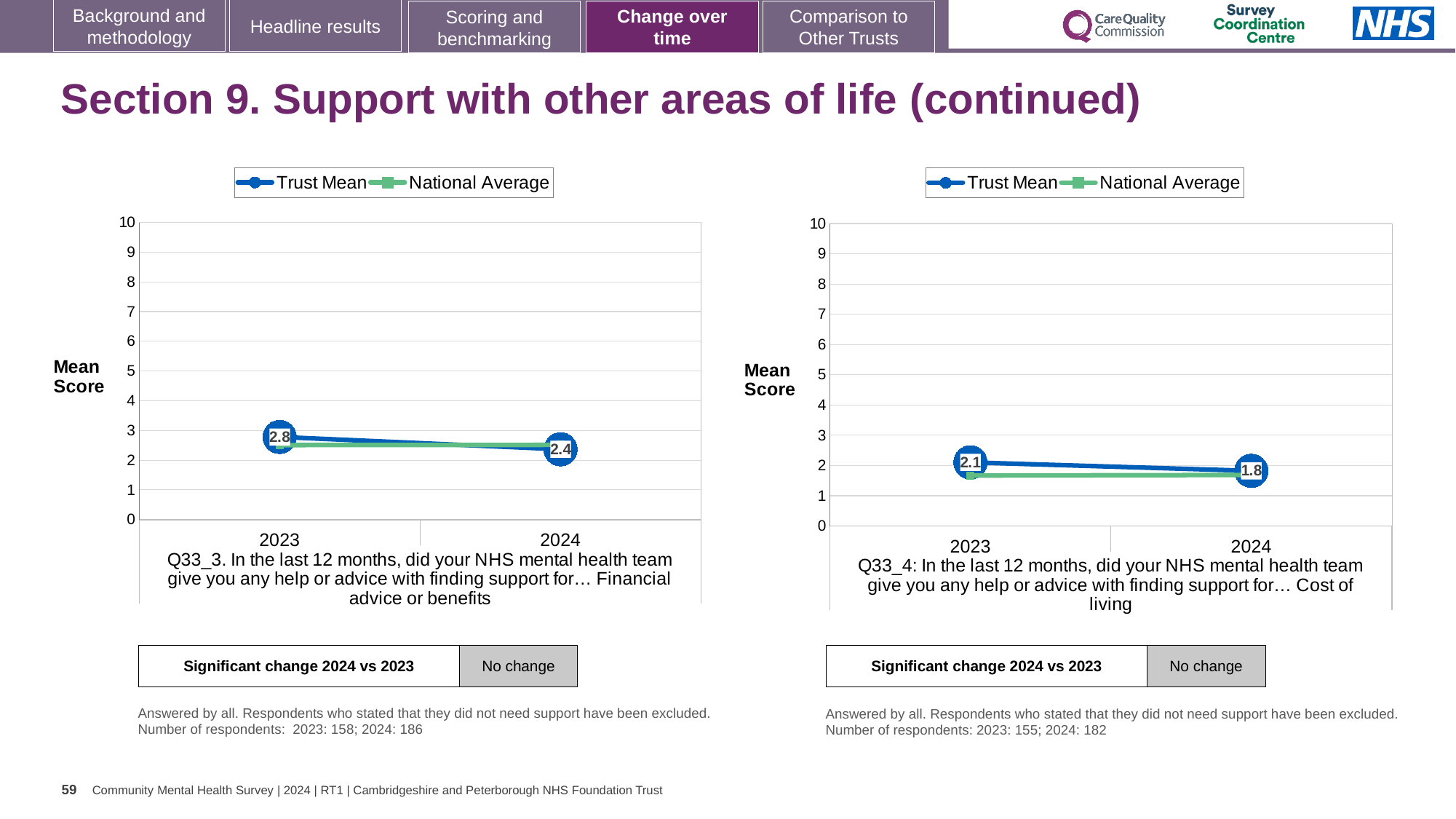
In the left chart (Q33_3), does the Trust Mean rise or fall from 2023 to 2024? fall What kind of chart is the right chart (Q33_4, Cost of living)? line chart In the left chart (Q33_3), is the National Average for 2024 greater or less than 5? less How many series does the legend of the left chart (Q33_3) list? 2 In the right chart (Q33_4, Cost of living), what is the Trust Mean for 2023? 2.1 In the right chart (Q33_4), what is the difference between the Trust Mean in 2023 and in 2024? 0.3 In the left chart (Q33_3, Financial advice or benefits), what is the Trust Mean for 2023? 2.8 In the left chart (Q33_3), by how much did the Trust Mean change from 2023 to 2024? 0.4 What does the 'Significant change 2024 vs 2023' box below the right chart (Q33_4) say? No change In the left chart (Q33_3, Financial advice or benefits), what is the Trust Mean for 2024? 2.4 In the right chart (Q33_4, Cost of living), what is the Trust Mean for 2024? 1.8 In the right chart (Q33_4), which year has the higher Trust Mean, 2023 or 2024? 2023